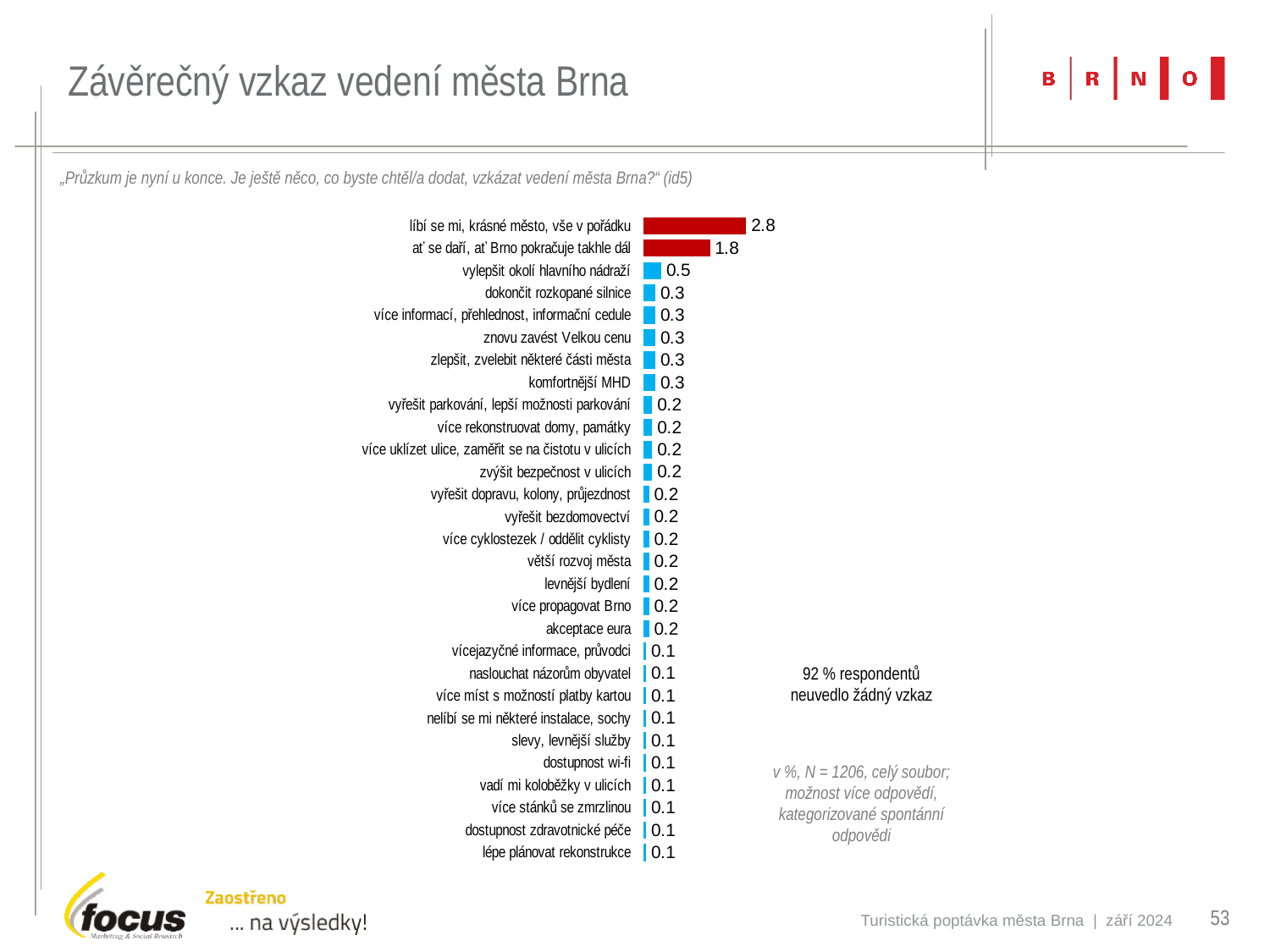
Which category has the highest value? líbí se mi, krásné město, vše v pořádku What is the value for "vylepšit okolí hlavního nádraží"? 0.5 What is the value for "líbí se mi, krásné město, vše v pořádku"? 2.8 What is the value for "ať se daří, ať Brno pokračuje takhle dál"? 1.8 What is the value for "komfortnější MHD"? 0.3 What kind of chart is shown on the slide? bar chart Which is larger: the value for "vylepšit okolí hlavního nádraží" or the value for "dokončit rozkopané silnice"? vylepšit okolí hlavního nádraží What is the difference between the values for "vylepšit okolí hlavního nádraží" and "vícejazyčné informace, průvodci"? 0.4 How many categories are shown in the chart? 29 What is the difference between the values for "líbí se mi, krásné město, vše v pořádku" and "ať se daří, ať Brno pokračuje takhle dál"? 1.0 What is the value for "akceptace eura"? 0.2 According to the note on the slide, what percentage of respondents gave no message? 92 %